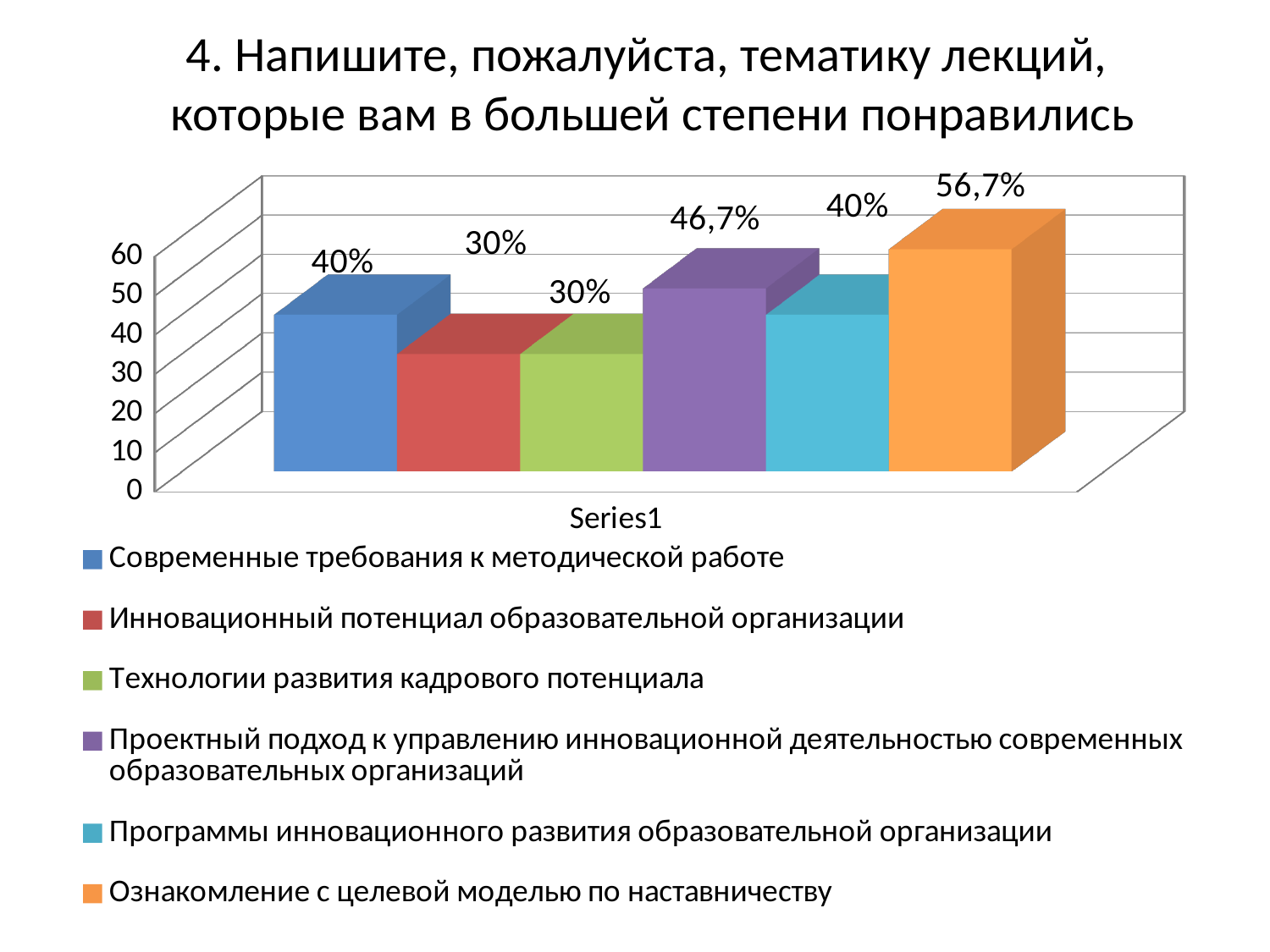
What is the value for "Современные требования к методической работе"? 40% Which is larger: the value for "Проектный подход к управлению инновационной деятельностью современных образовательных организаций" or the value for "Программы инновационного развития образовательной организации"? Проектный подход к управлению инновационной деятельностью современных образовательных организаций What is the value for "Ознакомление с целевой моделью по наставничеству"? 56,7% Which legend entry has the highest value? Ознакомление с целевой моделью по наставничеству What colour is the bar for "Ознакомление с целевой моделью по наставничеству"? orange What is the category label shown on the x axis? Series1 What is the value for "Проектный подход к управлению инновационной деятельностью современных образовательных организаций"? 46,7% What kind of chart is shown on the slide? bar chart What is the difference between the values for "Проектный подход к управлению инновационной деятельностью современных образовательных организаций" and "Современные требования к методической работе"? 6,7% What is the value for "Инновационный потенциал образовательной организации"? 30% What is the difference between the values for "Ознакомление с целевой моделью по наставничеству" and "Технологии развития кадрового потенциала"? 26,7% How many entries does the legend list? 6